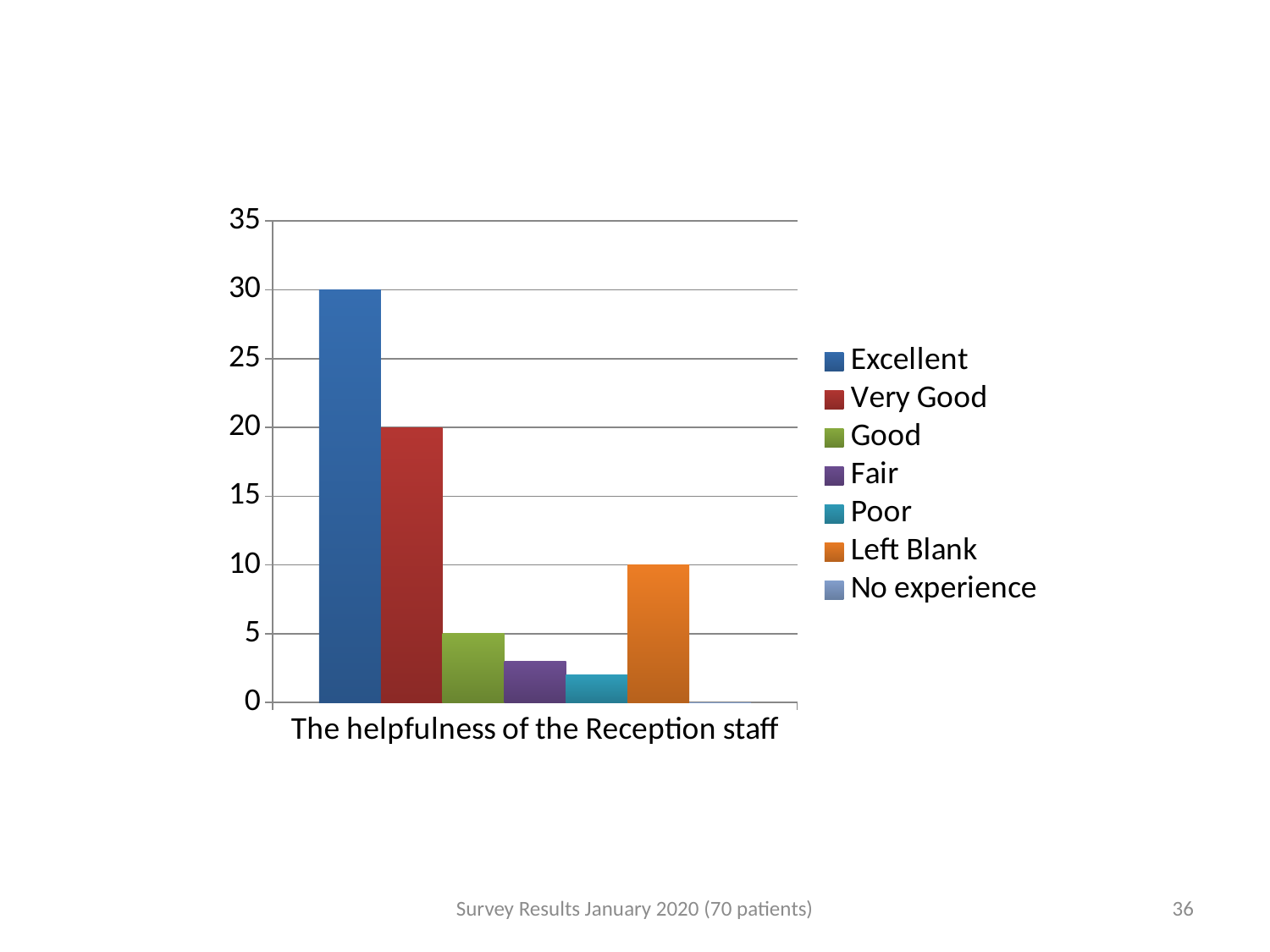
What is the value for Left Blank? 10 What is the difference between the values for Excellent and Very Good? 10 What is the category label shown on the x axis? The helpfulness of the Reception staff What is the value for Good? 5 Which is larger, the value for Left Blank or the value for Good? Left Blank What is the value for Very Good? 20 Is the value for Fair greater or less than 5? less What is the value for Excellent? 30 Which series has the highest value? Excellent What kind of chart is shown on the slide? bar chart How many series does the legend list? 7 Which series has the lowest value? No experience